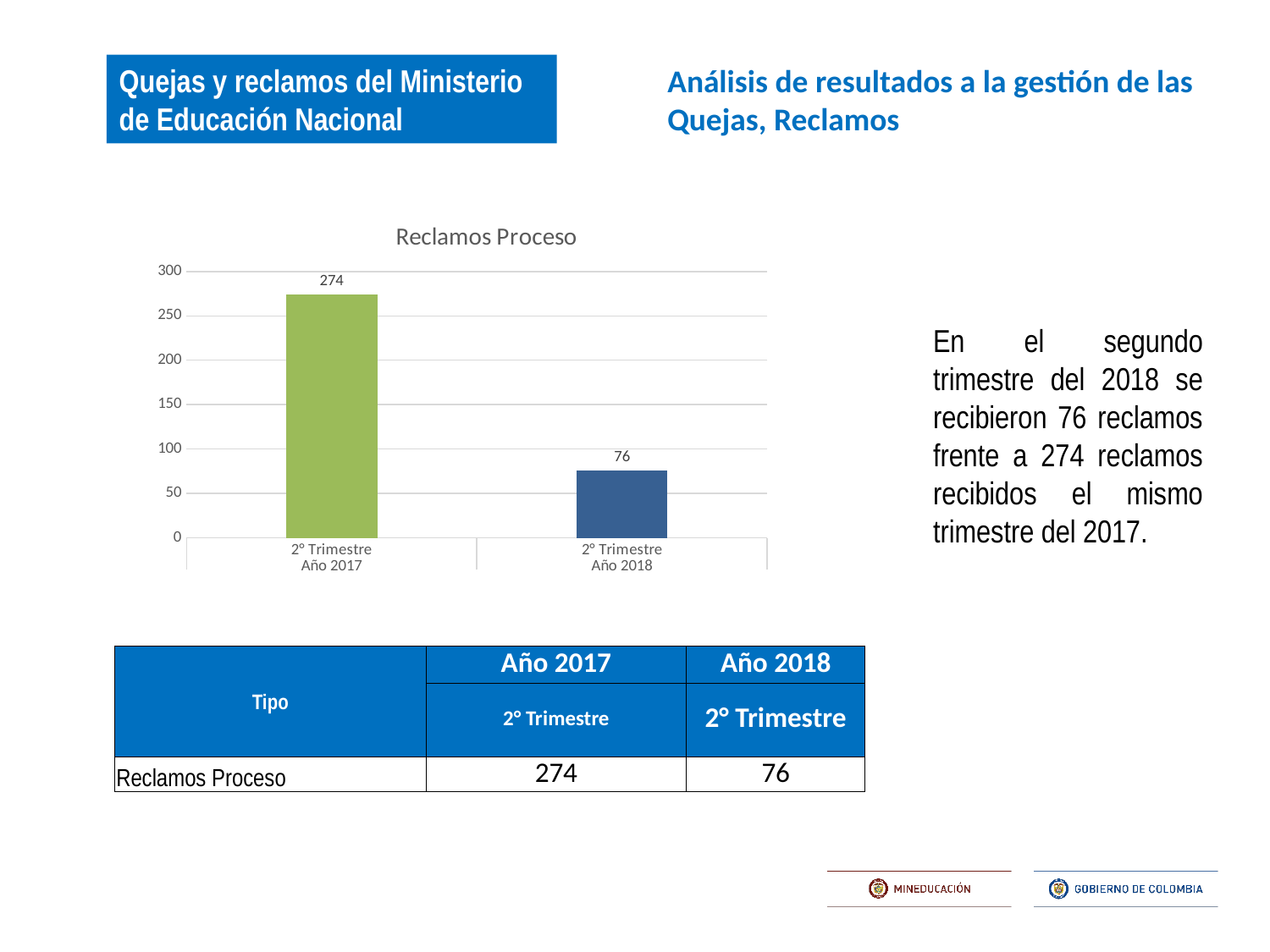
Which category has the lowest value in the Reclamos Proceso chart? 2° Trimestre Año 2018 What is the value for 2° Trimestre Año 2018 in the Reclamos Proceso chart? 76 Which is larger in the Reclamos Proceso chart: the value for 2° Trimestre Año 2017 or 2° Trimestre Año 2018? 2° Trimestre Año 2017 How many categories are shown in the Reclamos Proceso chart? 2 Is the value for 2° Trimestre Año 2018 greater or less than 100? less Which category has the highest value in the Reclamos Proceso chart? 2° Trimestre Año 2017 What kind of chart is the Reclamos Proceso chart? bar chart Do the values rise or fall from 2017 to 2018 in the Reclamos Proceso chart? fall What is the value for 2° Trimestre Año 2017 in the Reclamos Proceso chart? 274 What is the title of the chart on the slide? Reclamos Proceso Is the value for 2° Trimestre Año 2017 greater or less than 250? greater What is the difference between the 2017 and 2018 values in the Reclamos Proceso chart? 198